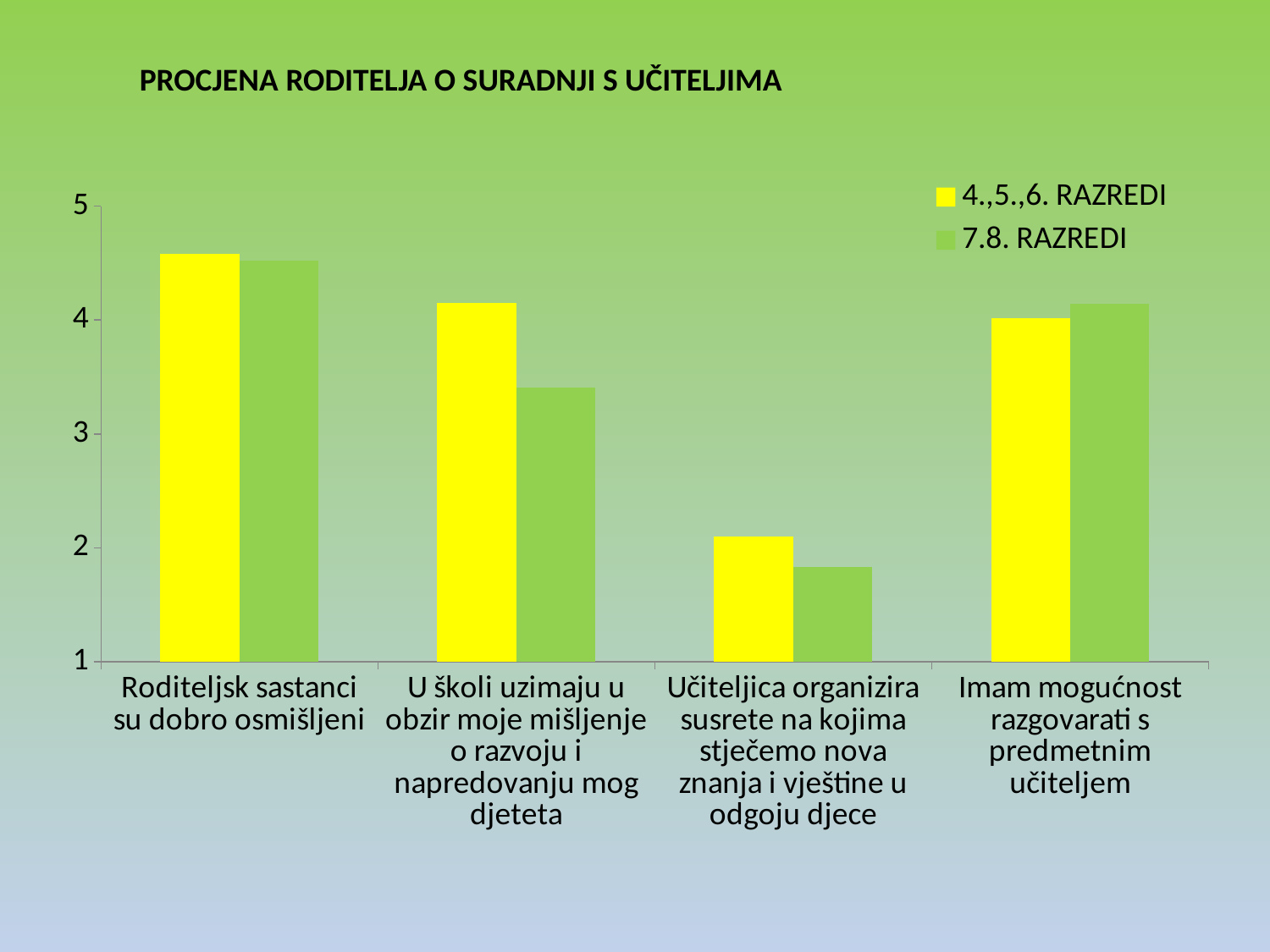
For the series 7.8. RAZREDI, which category has the lowest value? Učiteljica organizira susrete na kojima stječemo nova znanja i vještine u odgoju djece For the series 4.,5.,6. RAZREDI, which category has the highest value? Roditeljsk sastanci su dobro osmišljeni For the series 4.,5.,6. RAZREDI, which category has the lowest value? Učiteljica organizira susrete na kojima stječemo nova znanja i vještine u odgoju djece What is the title of the chart? PROCJENA RODITELJA O SURADNJI S UČITELJIMA What kind of chart is shown on the slide? bar chart For the category 'U školi uzimaju u obzir moje mišljenje o razvoju i napredovanju mog djeteta', which series has the larger value, 4.,5.,6. RAZREDI or 7.8. RAZREDI? 4.,5.,6. RAZREDI How many categories are shown on the x axis? 4 How many series does the legend list? 2 Is the value for 4.,5.,6. RAZREDI in the category 'Učiteljica organizira susrete na kojima stječemo nova znanja i vještine u odgoju djece' greater or less than 3? less Is the value for 4.,5.,6. RAZREDI in the category 'Roditeljsk sastanci su dobro osmišljeni' greater or less than 4? greater Which colour represents the series 7.8. RAZREDI? green Is the value for 7.8. RAZREDI in the category 'U školi uzimaju u obzir moje mišljenje o razvoju i napredovanju mog djeteta' greater or less than 4? less